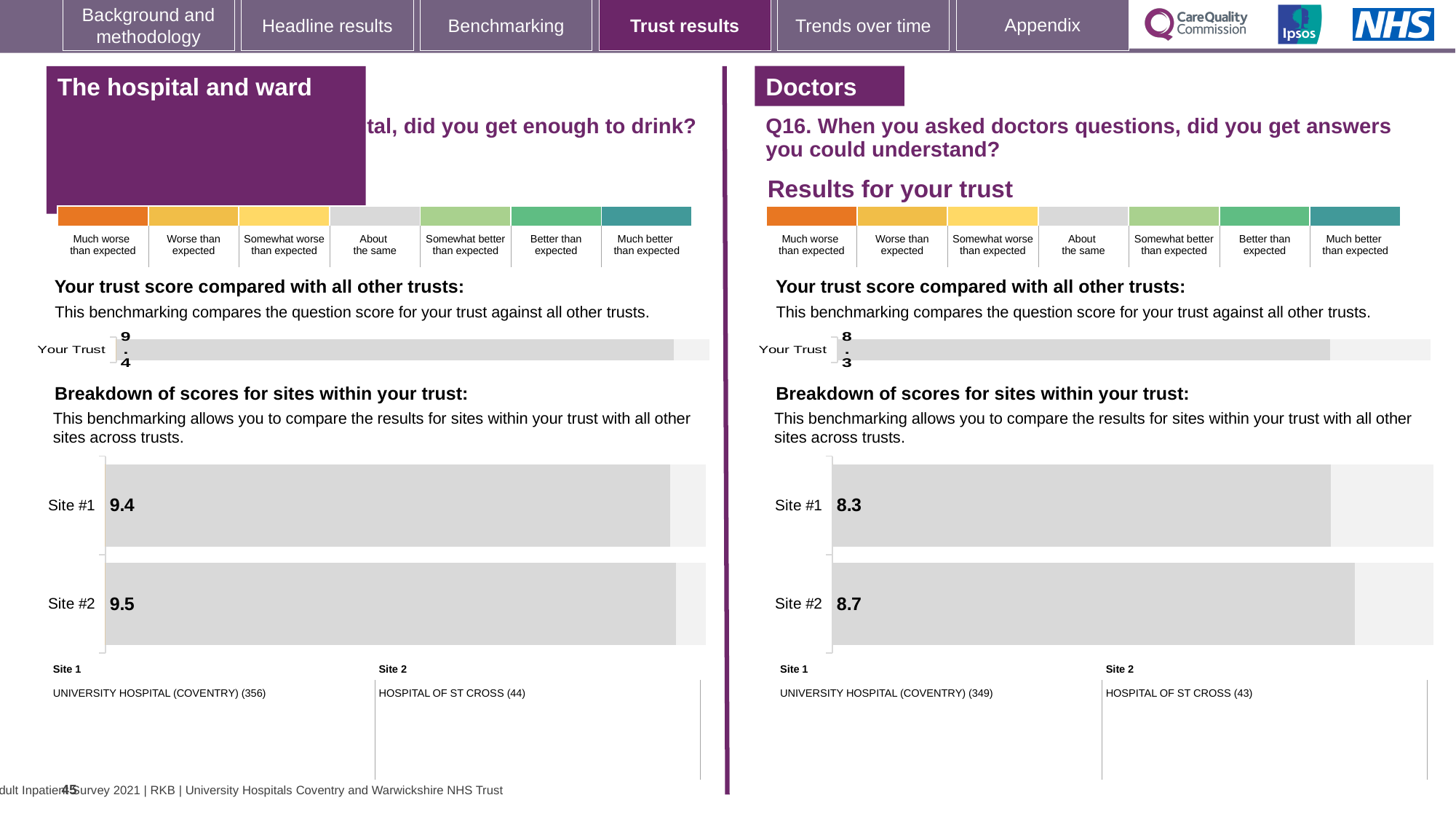
On the left-hand site breakdown chart, what is the difference between the Site #2 and Site #1 scores? 0.1 On the right-hand (Q16, Doctors) site breakdown chart, what is the difference between the Site #2 and Site #1 scores? 0.4 Is the Site #1 score on the left-hand site breakdown chart larger or smaller than the Site #1 score on the right-hand (Q16, Doctors) chart? Larger On the right-hand (Q16, Doctors) site breakdown chart, which site has the higher score? Site #2 What kind of chart is used for the site breakdown on the left-hand side of the slide? Bar chart On the left-hand 'Your trust score compared with all other trusts' chart, what is the value shown for Your Trust? 9.4 On the left-hand 'Breakdown of scores for sites within your trust' chart, what is the score for Site #1? 9.4 On the right-hand (Q16, Doctors) 'Breakdown of scores for sites within your trust' chart, what is the score for Site #1? 8.3 How many sites are shown on the right-hand (Q16, Doctors) site breakdown chart? 2 On the right-hand (Q16, Doctors) 'Breakdown of scores for sites within your trust' chart, what is the score for Site #2? 8.7 On the left-hand 'Breakdown of scores for sites within your trust' chart, what is the score for Site #2? 9.5 On the right-hand (Q16, Doctors) 'Your trust score compared with all other trusts' chart, what is the value shown for Your Trust? 8.3